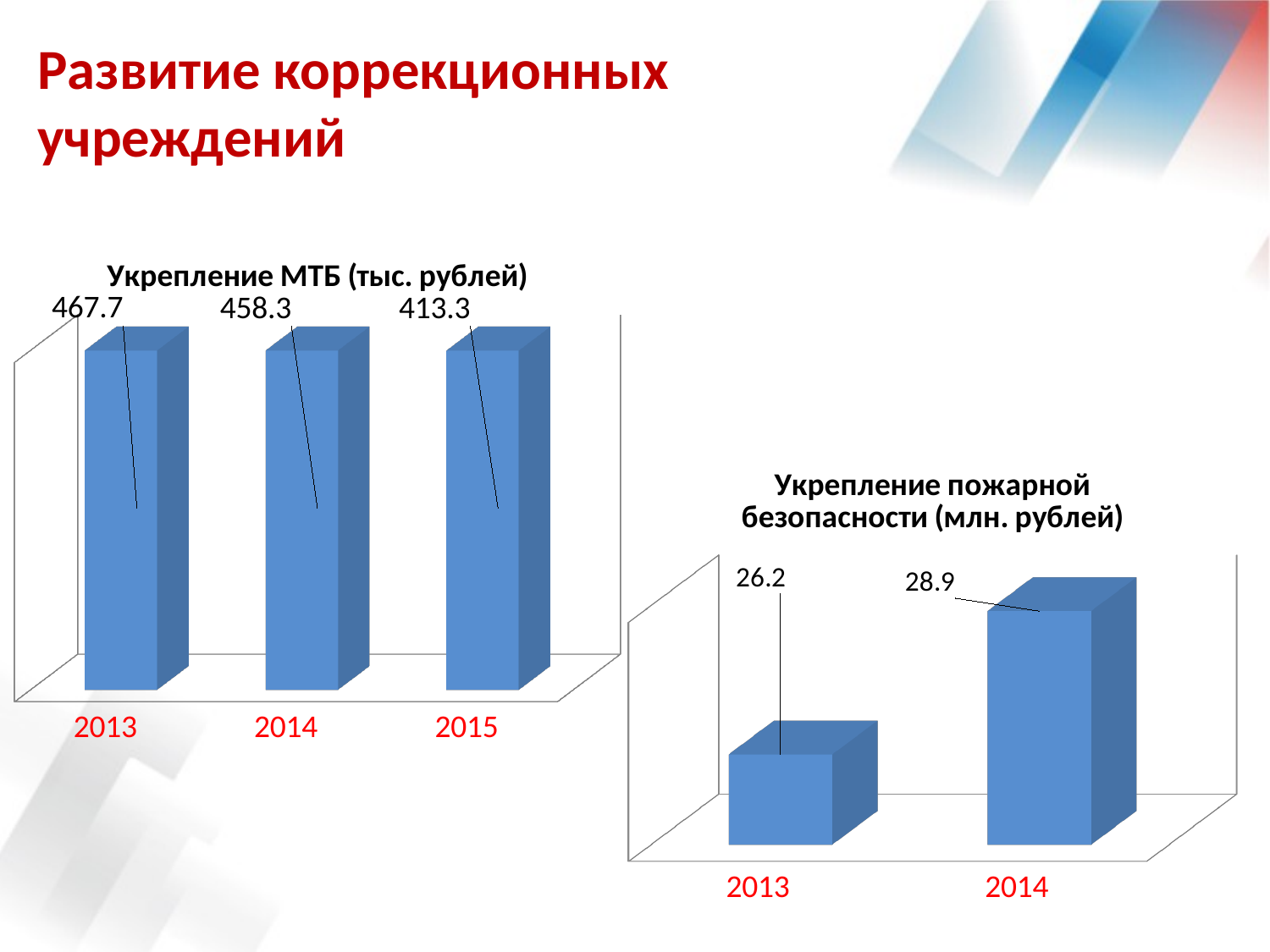
In the chart titled "Укрепление пожарной безопасности (млн. рублей)", which year has the larger value, 2013 or 2014? 2014 What kind of chart is the one titled "Укрепление пожарной безопасности (млн. рублей)"? bar chart In the chart titled "Укрепление МТБ (тыс. рублей)", what is the value for 2015? 413.3 In the chart titled "Укрепление МТБ (тыс. рублей)", which year has the lowest value? 2015 In the chart titled "Укрепление МТБ (тыс. рублей)", what is the value for 2013? 467.7 In the chart titled "Укрепление МТБ (тыс. рублей)", which year has the highest value? 2013 In the chart titled "Укрепление МТБ (тыс. рублей)", do the values rise or fall from 2013 to 2015? fall In the chart titled "Укрепление МТБ (тыс. рублей)", how many years are shown? 3 In the chart titled "Укрепление пожарной безопасности (млн. рублей)", what is the difference between the 2014 and 2013 values? 2.7 In the chart titled "Укрепление пожарной безопасности (млн. рублей)", what is the value for 2013? 26.2 In the chart titled "Укрепление пожарной безопасности (млн. рублей)", what is the value for 2014? 28.9 In the chart titled "Укрепление МТБ (тыс. рублей)", what is the difference between the 2014 and 2015 values? 45.0